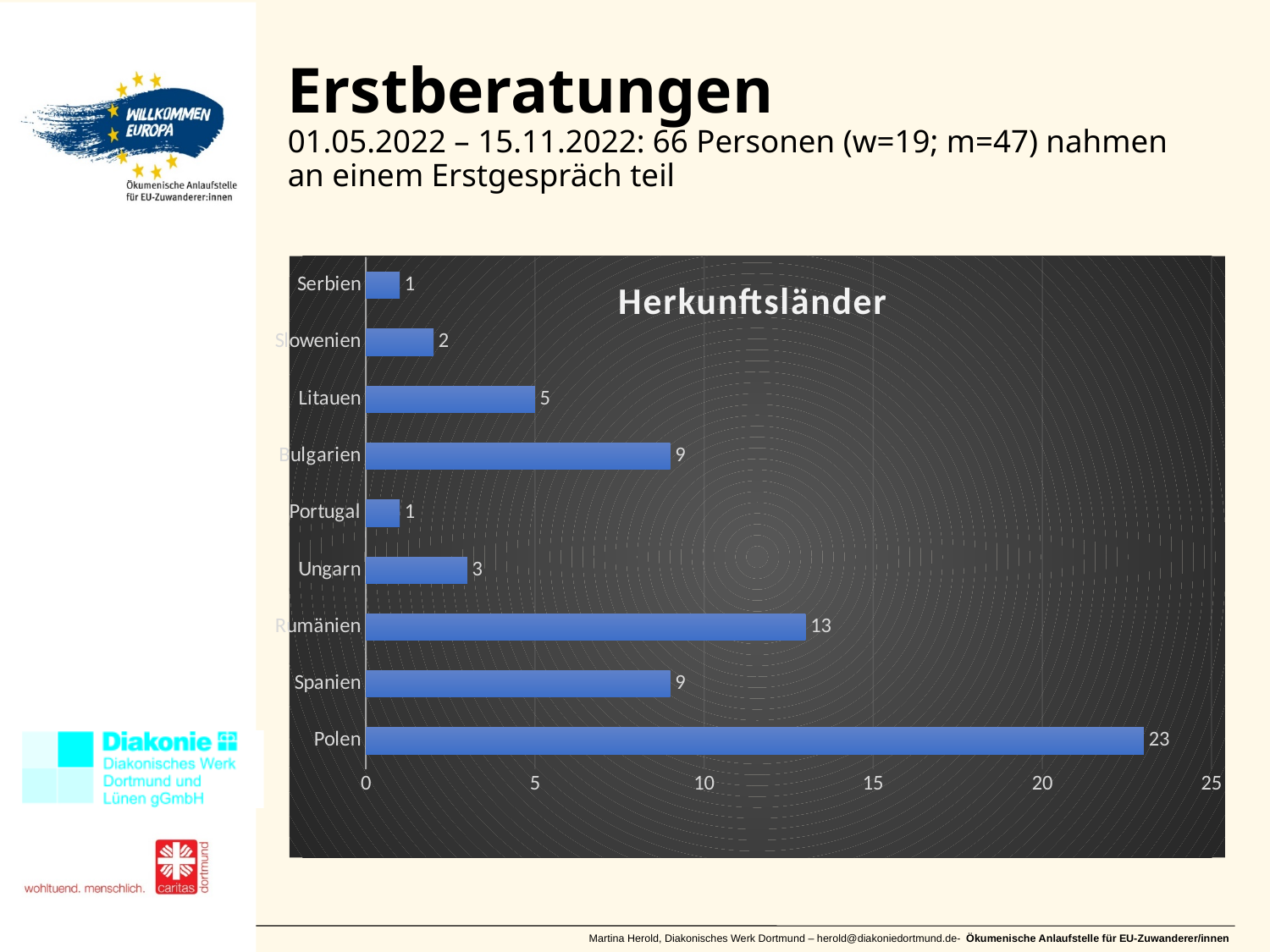
What is the value for Polen in the Herkunftsländer chart? 23 Which country has the highest value in the Herkunftsländer chart? Polen What is the difference between the values for Polen and Rumänien? 10 What kind of chart is the Herkunftsländer chart? bar chart What is the value for Litauen in the Herkunftsländer chart? 5 What is the value for Spanien in the Herkunftsländer chart? 9 Is the value for Rumänien greater or less than 10? greater What is the difference between the values for Bulgarien and Litauen? 4 Which has a larger value, Bulgarien or Ungarn? Bulgarien How many countries are shown in the Herkunftsländer chart? 9 What is the title of the chart? Herkunftsländer What is the value for Rumänien in the Herkunftsländer chart? 13